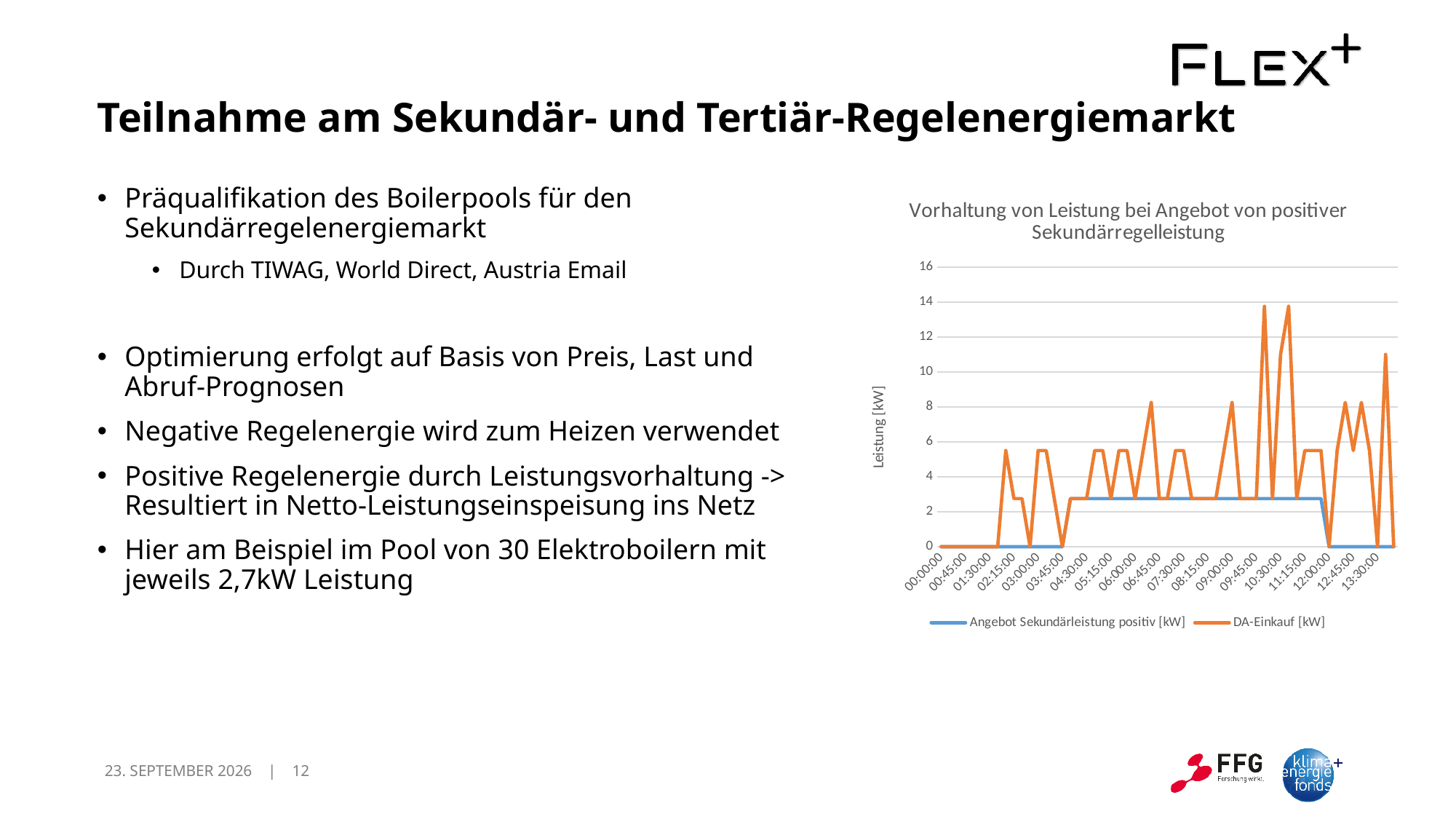
What kind of chart is shown on the slide? line chart What is the title of the chart? Vorhaltung von Leistung bei Angebot von positiver Sekundärregelleistung What is the value of DA-Einkauf [kW] at 00:00:00? 0 What is the value of Angebot Sekundärleistung positiv [kW] at 00:45:00? 0 Which series reaches the higher maximum value, Angebot Sekundärleistung positiv [kW] or DA-Einkauf [kW]? DA-Einkauf [kW] How many series does the chart legend list? 2 What is the label of the vertical axis of the chart? Leistung [kW] Does the value of Angebot Sekundärleistung positiv [kW] rise or fall between 11:15:00 and 12:45:00? fall Is the highest value reached by DA-Einkauf [kW] greater or less than 12? greater Is the value of Angebot Sekundärleistung positiv [kW] at 08:15:00 greater or less than 2? greater How many time labels are shown on the x axis of the chart? 19 Is the value of Angebot Sekundärleistung positiv [kW] at 08:15:00 greater or less than 4? less